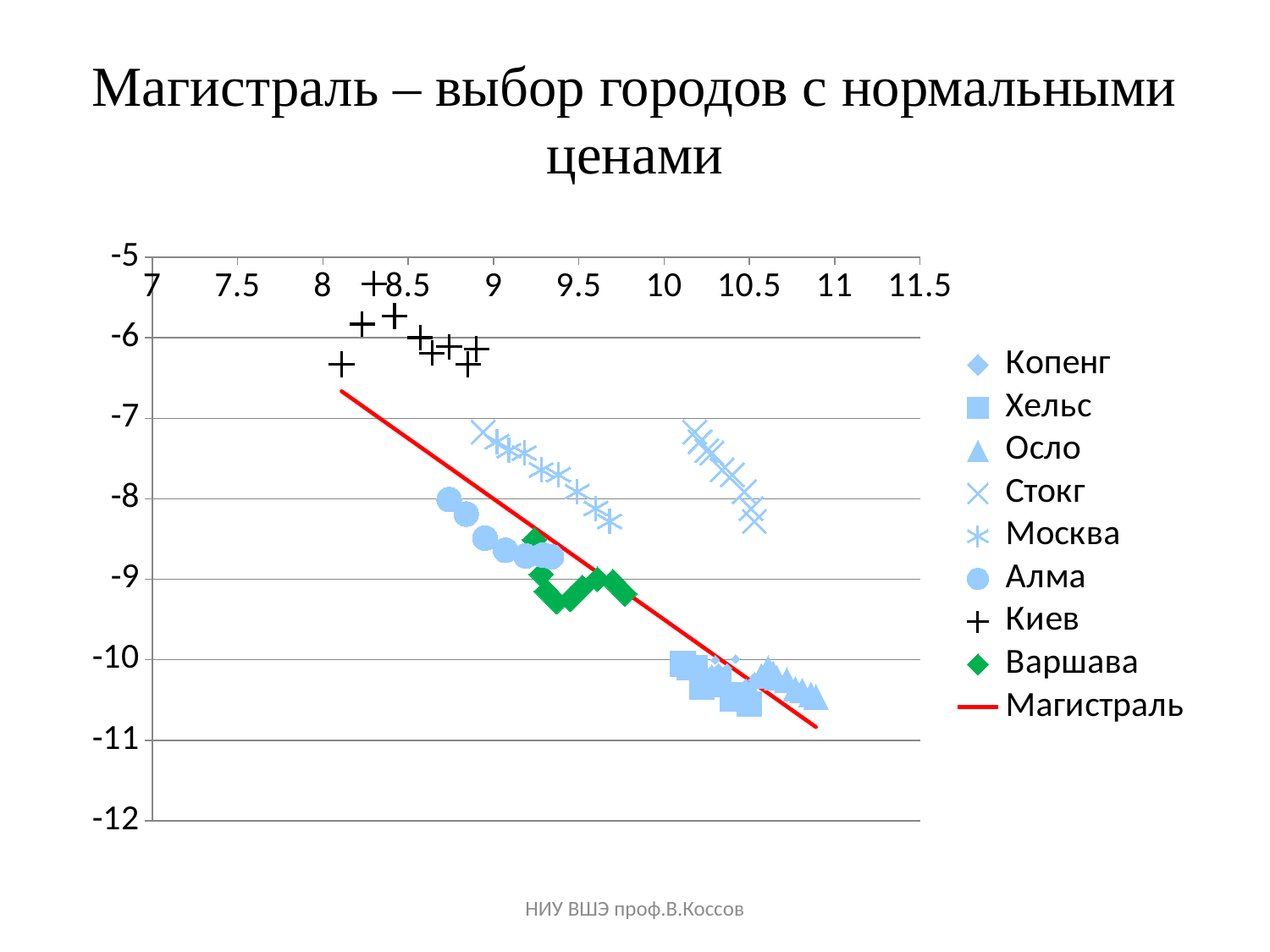
What colour is the Магистраль line? red Which series lies further to the right on the horizontal axis, Осло or Алма? Осло Are the vertical-axis values for Хельс greater or less than -9? less Which series has the highest values on the vertical axis? Киев Does the Магистраль line rise or fall as the x-axis value increases? fall Are the vertical-axis values for Киев greater or less than -7? greater How many series does the legend list? 9 What kind of chart is shown on the slide? scatter chart What is the title of the chart? Магистраль – выбор городов с нормальными ценами Are the horizontal-axis values for Осло greater or less than 10? greater Which series has higher vertical-axis values, Киев or Осло? Киев